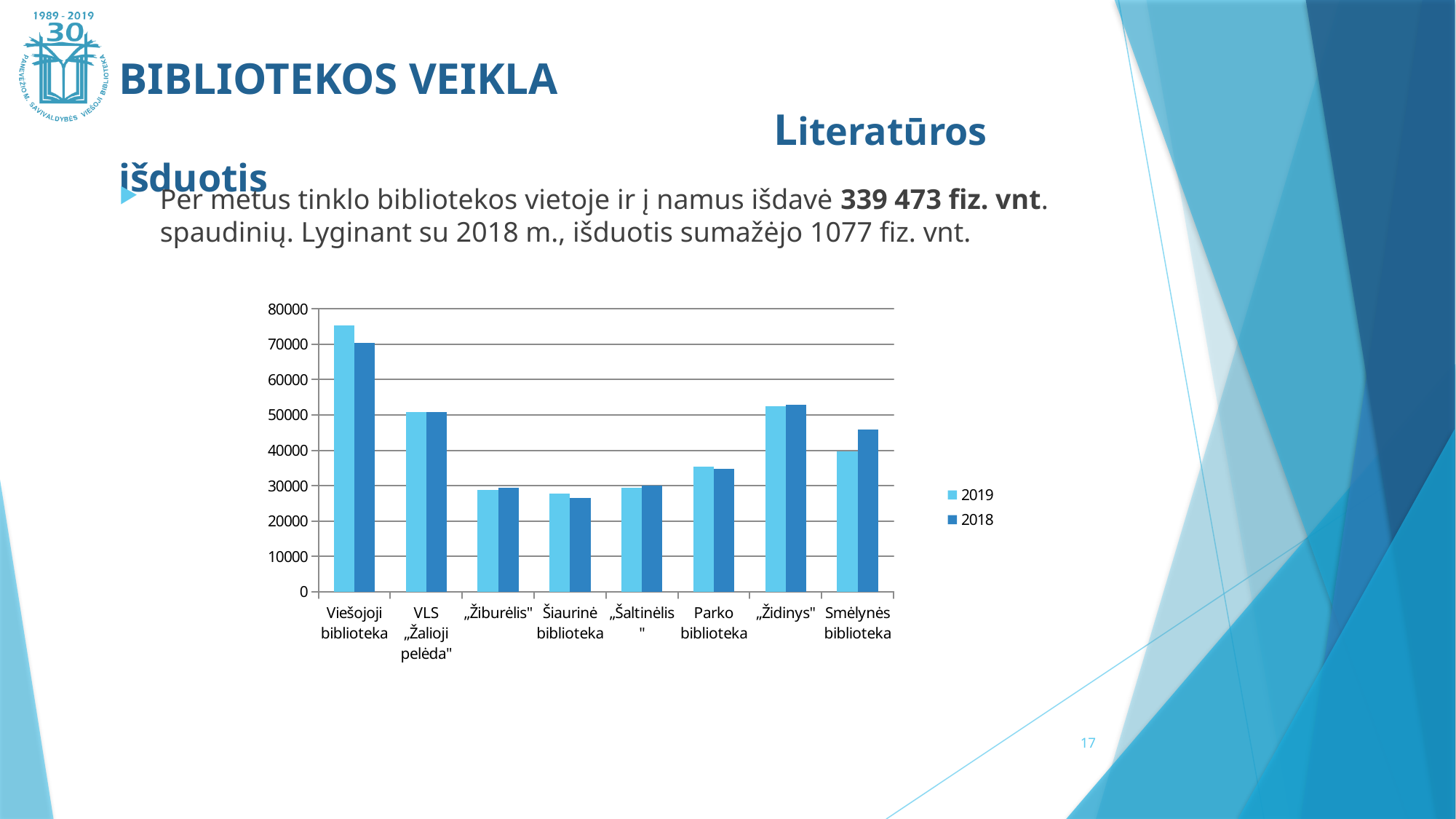
How many library categories are shown on the x axis of the chart? 8 Which series is shown in the lighter blue colour in the chart? 2019 For Smėlynės biblioteka, which year has the larger value, 2019 or 2018? 2018 What kind of chart is shown on the slide? bar chart Which library has the highest value for 2019 in the chart? Viešojoji biblioteka Is the 2019 value for Viešojoji biblioteka greater or less than 70000? greater Which library has the lowest value for 2018 in the chart? Šiaurinė biblioteka Is the 2019 value for Smėlynės biblioteka greater or less than 50000? less For Viešojoji biblioteka, which year has the larger value, 2019 or 2018? 2019 How many series does the chart legend list? 2 Is the 2019 value for Parko biblioteka greater or less than 30000? greater